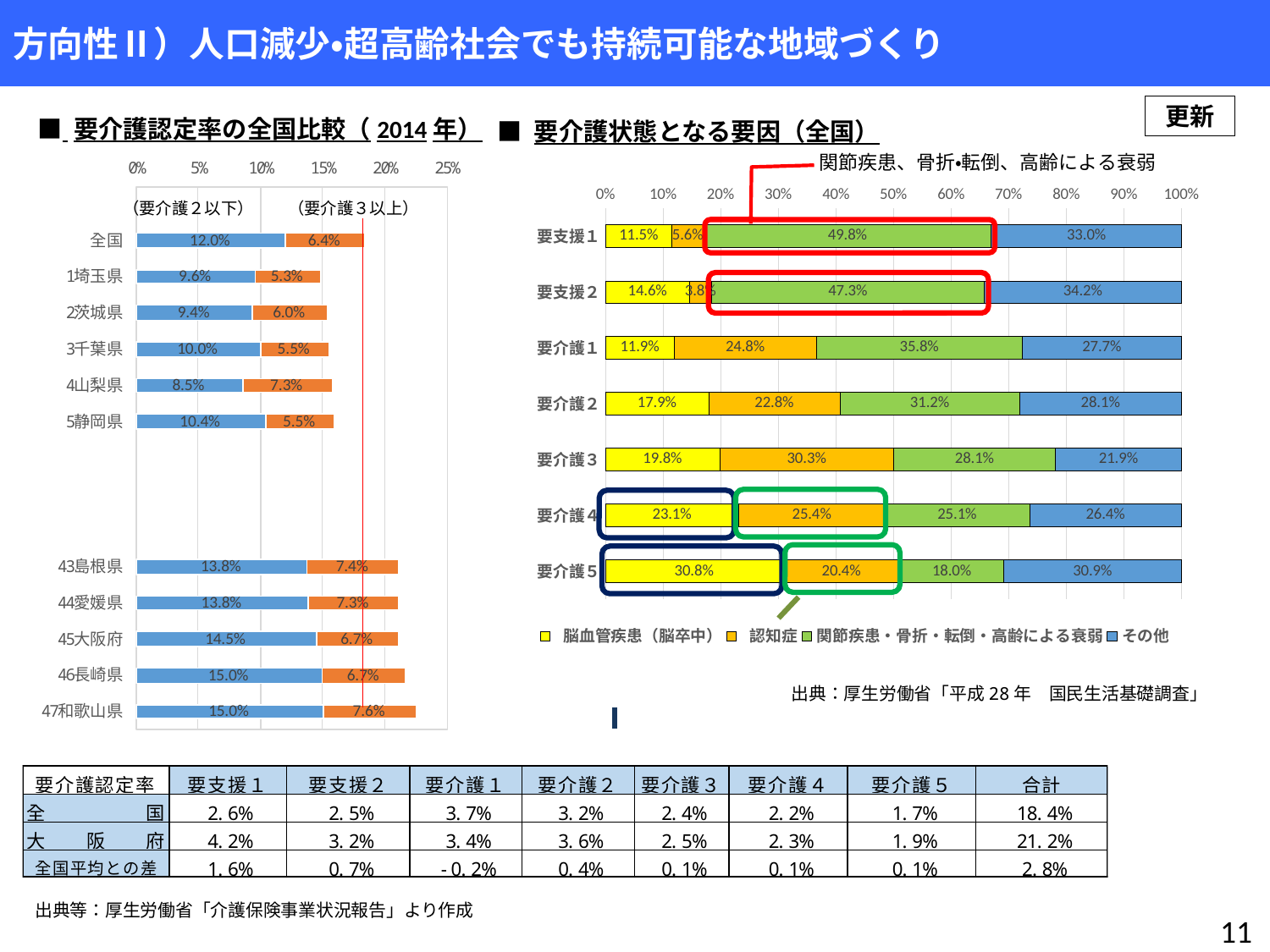
In the chart titled 要介護状態となる要因（全国）, what is the 脳血管疾患（脳卒中） value for 要介護5? 30.8% In the chart titled 要介護状態となる要因（全国）, which is larger: the 認知症 value for 要介護1 or for 要介護5? 要介護1 In the chart titled 要介護認定率の全国比較（2014年）, which category has the lowest 要介護2以下 value? 4山梨県 What kind of chart is the chart titled 要介護状態となる要因（全国）? Stacked bar chart In the chart titled 要介護認定率の全国比較（2014年）, what is the total of the stacked bar for 47和歌山県? 22.6% In the chart titled 要介護認定率の全国比較（2014年）, what is the 要介護3以上 value for 45大阪府? 6.7% In the chart titled 要介護認定率の全国比較（2014年）, what is the difference between the 要介護2以下 values for 45大阪府 and 全国? 2.5% In the chart titled 要介護状態となる要因（全国）, what is the 認知症 value for 要介護3? 30.3% In the chart titled 要介護認定率の全国比較（2014年）, what is the 要介護2以下 value for 全国? 12.0% In the chart titled 要介護状態となる要因（全国）, which category has the highest 関節疾患・骨折・転倒・高齢による衰弱 value? 要支援1 In the chart titled 要介護認定率の全国比較（2014年）, how many categories are plotted? 11 In the chart titled 要介護状態となる要因（全国）, how many series does the legend list? 4